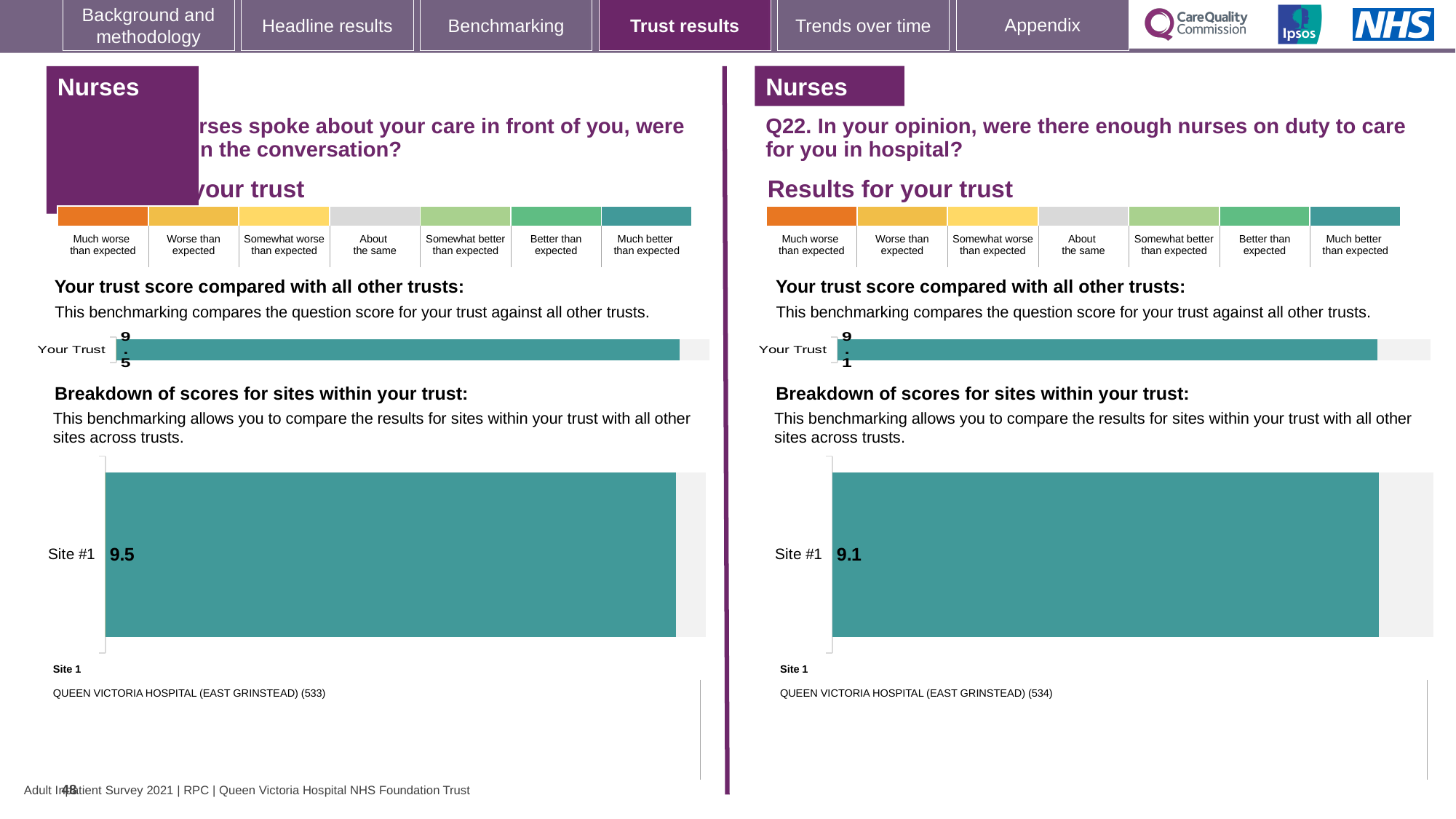
What colour is the Site #1 bar on the left-hand panel? Teal How many sites are shown in the 'Breakdown of scores for sites within your trust' chart on the right-hand panel (Q22)? 1 On the right-hand panel (Q22), which hospital is listed as Site 1? QUEEN VICTORIA HOSPITAL (EAST GRINSTEAD) (534) Which Site #1 score is larger: the one on the left-hand panel or the one on the right-hand panel (Q22)? Left-hand panel On the right-hand panel (Q22), what is the score shown for Site #1? 9.1 On the left-hand panel, what is the score shown for 'Your Trust' in the trust comparison bar? 9.5 On the left-hand panel, what is the score shown for Site #1? 9.5 How many sites are shown in the 'Breakdown of scores for sites within your trust' chart on the left-hand panel? 1 On the right-hand panel (Q22), what is the score shown for 'Your Trust' in the trust comparison bar? 9.1 What type of chart is used to show the Site #1 score on the right-hand panel (Q22)? Bar chart What is the difference between the Site #1 score on the left-hand panel and the Site #1 score on the right-hand panel (Q22)? 0.4